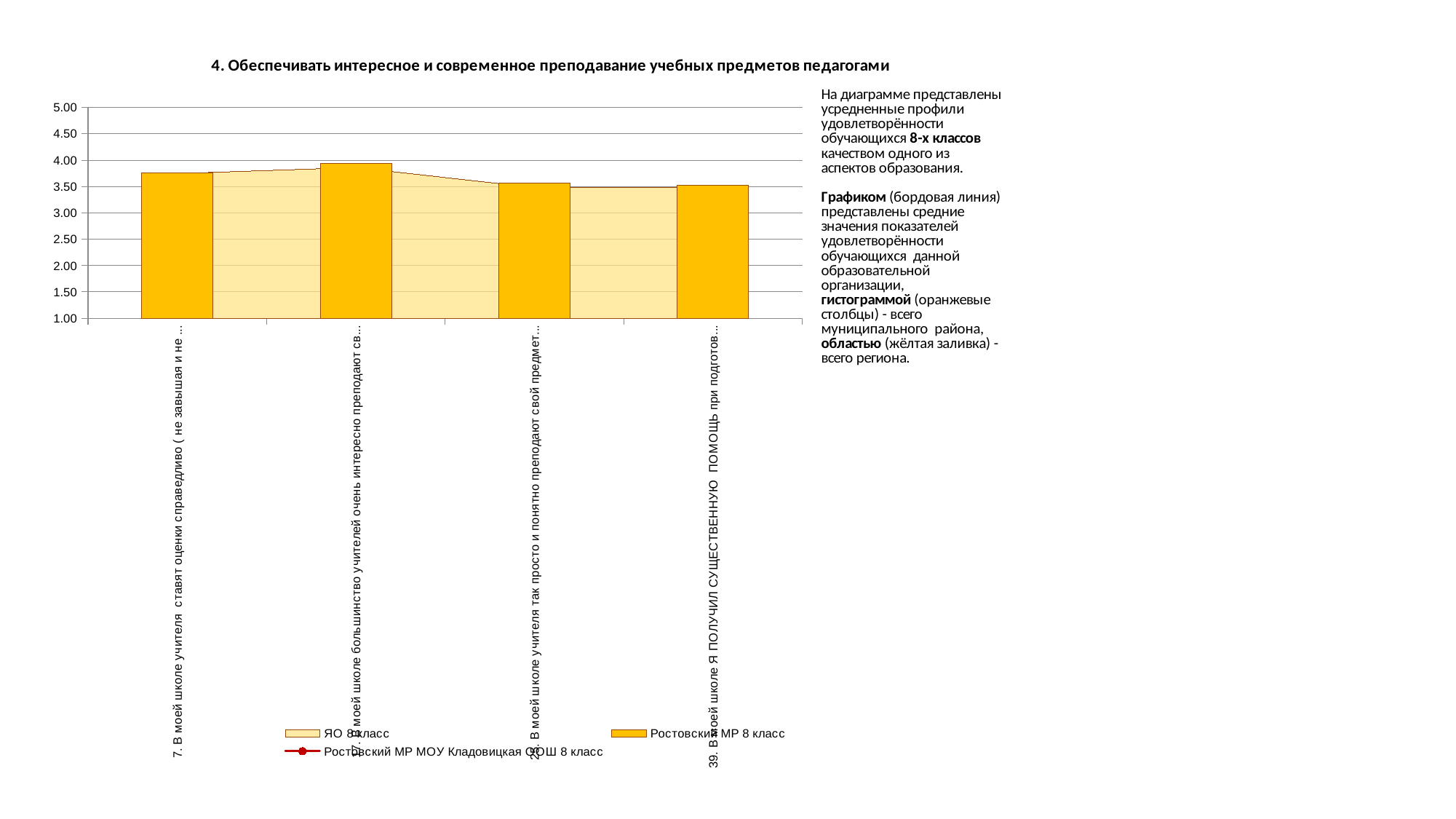
What is the maximum value shown on the chart's vertical axis? 5.00 Which series is drawn as orange bars in the chart? Ростовский МР 8 класс How many categories are shown on the x axis of the chart? 4 Which category has the highest orange bar (Ростовский МР 8 класс)? В моей школе большинство учителей очень интересно преподают свой предмет Is the Ростовский МР 8 класс bar for category 7 (учителя ставят оценки справедливо) greater or less than 4.00? less How many series does the chart legend list? 3 What is the title of the chart? 4. Обеспечивать интересное и современное преподавание учебных предметов педагогами Is the Ростовский МР 8 класс bar for category 7 (учителя ставят оценки справедливо) greater or less than 3.50? greater